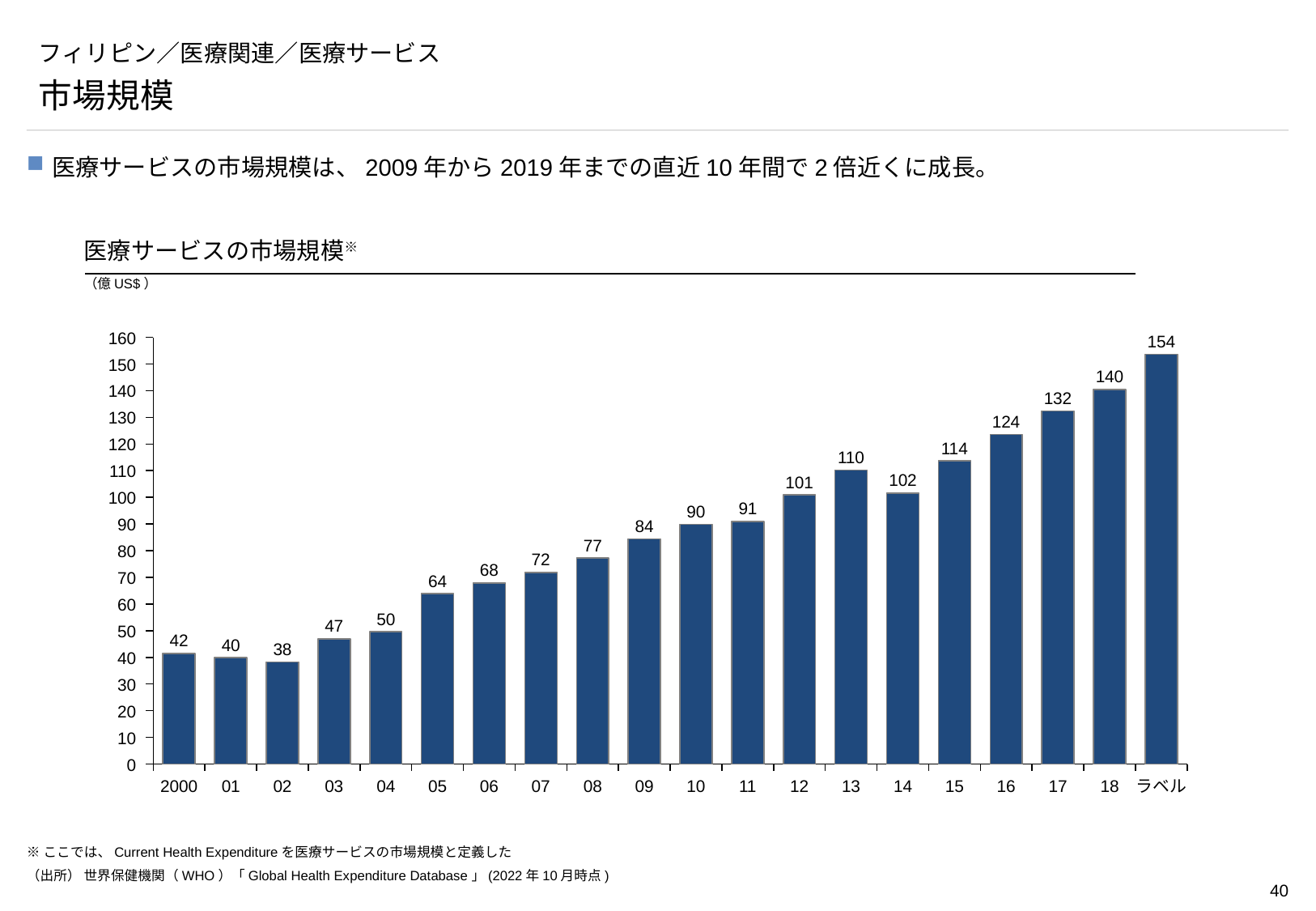
What is the value for 09? 84 Which category has the highest value? ラベル What is the difference between the values for 18 and 17? 8 Which is larger, the value for 13 or the value for 14? 13 What is the value for 13? 110 Which category has the lowest value? 02 What type of chart is shown on the slide? bar chart Do the values generally rise or fall from 2000 to the last bar? rise What is the value for 2000? 42 What is the value of the last bar, labelled ラベル? 154 How many bars are plotted in the chart? 20 What unit is shown for the chart's values? 億US$